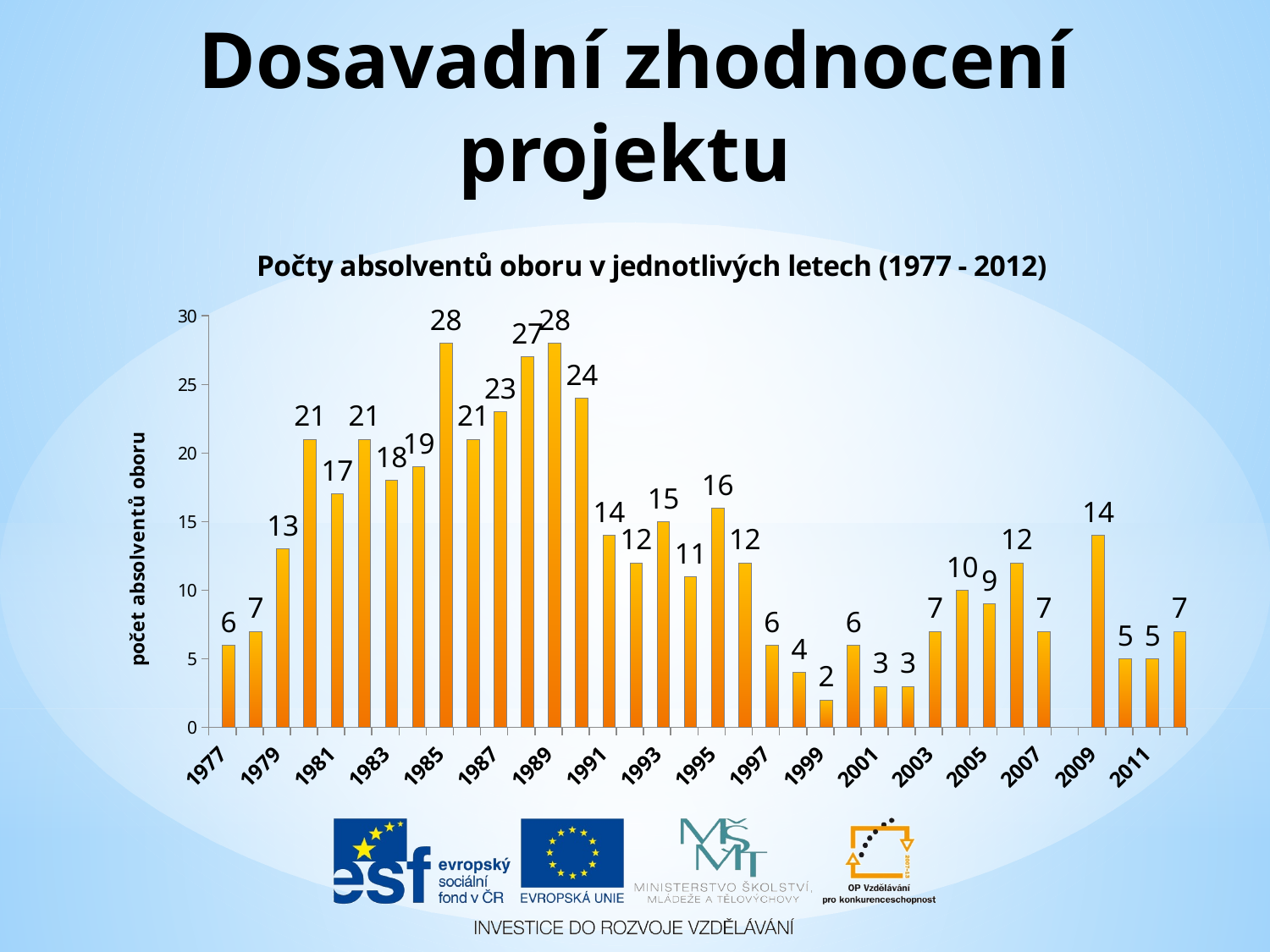
What is the value for 1977? 6 Do the values rise or fall from 1989 to 1999? fall What is the value for 1999? 2 What is the value for 1985? 28 What is the value for 2009? 14 Which year has the lowest bar on the chart? 1999 What is the title of the chart? Počty absolventů oboru v jednotlivých letech (1977 - 2012) Which is larger, the value for 1993 or the value for 1995? 1995 What is the difference between the values for 1989 and 1999? 26 What kind of chart is shown on the slide? bar chart Is the value for 1987 greater or less than 20? greater What is the difference between the values for 1985 and 1977? 22